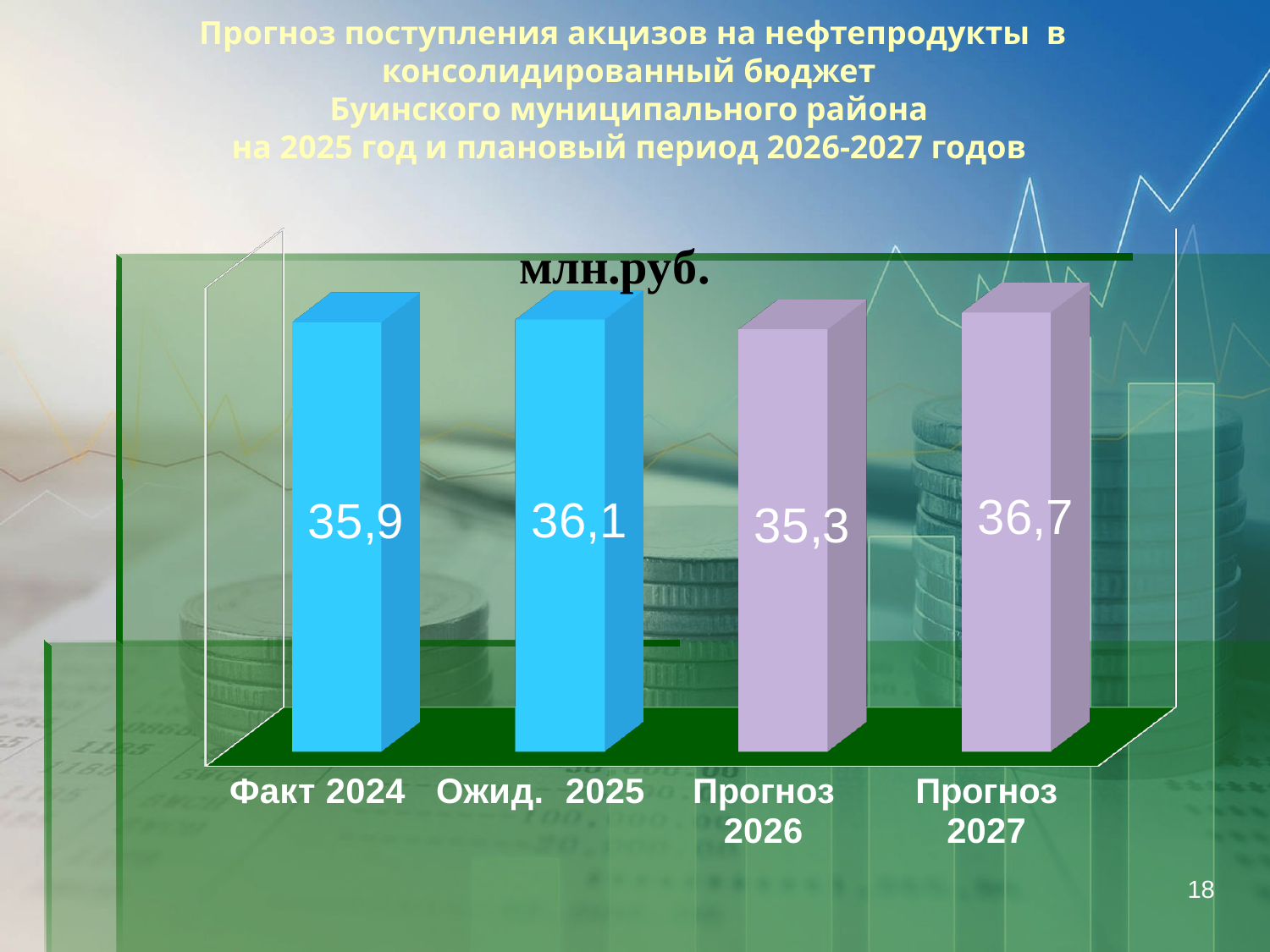
Which is larger, the value for Ожид. 2025 or the value for Прогноз 2026? Ожид. 2025 What is the difference between the values for Прогноз 2027 and Прогноз 2026? 1,4 What is the value for Ожид. 2025? 36,1 What is the value for Прогноз 2026? 35,3 What is the difference between the values for Ожид. 2025 and Факт 2024? 0,2 What is the value for Факт 2024? 35,9 What unit label is shown above the chart? млн.руб. What kind of chart is shown on the slide? Bar chart How many categories are shown on the chart? 4 Which category has the highest value? Прогноз 2027 What is the value for Прогноз 2027? 36,7 Which category has the lowest value? Прогноз 2026